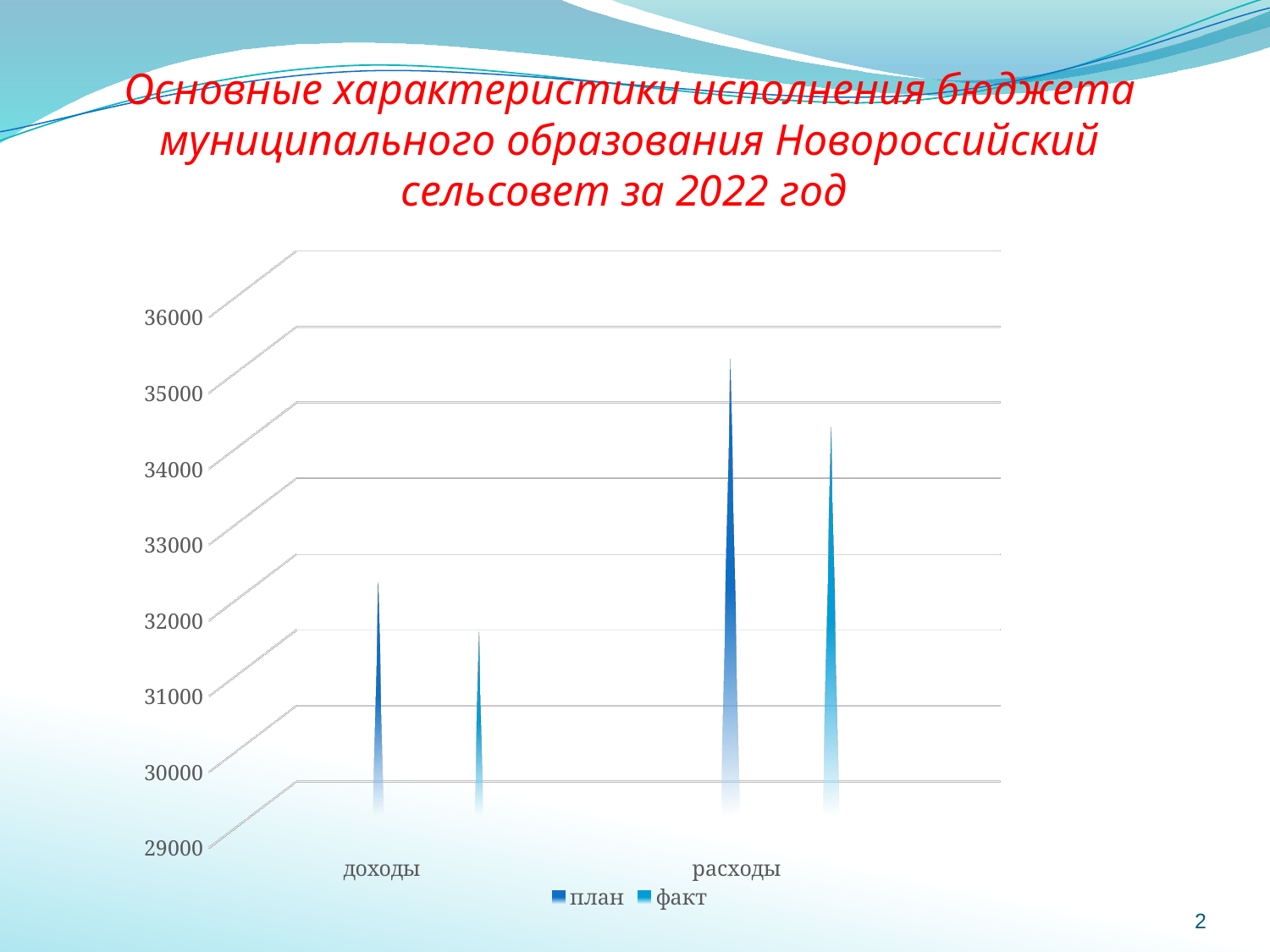
Is the план value for доходы greater or less than 32000? greater How many categories are shown on the x axis of the chart? 2 What kind of chart is shown on the slide? bar chart What are the two series named in the chart legend? план and факт Is the факт value for расходы greater or less than 34000? greater Which category and series has the highest value in the chart? расходы, план For доходы, which is larger: план or факт? план How many series does the chart legend list? 2 Which category and series has the lowest value in the chart? доходы, факт What are the two categories on the x axis of the chart? доходы and расходы For расходы, which is larger: план or факт? план